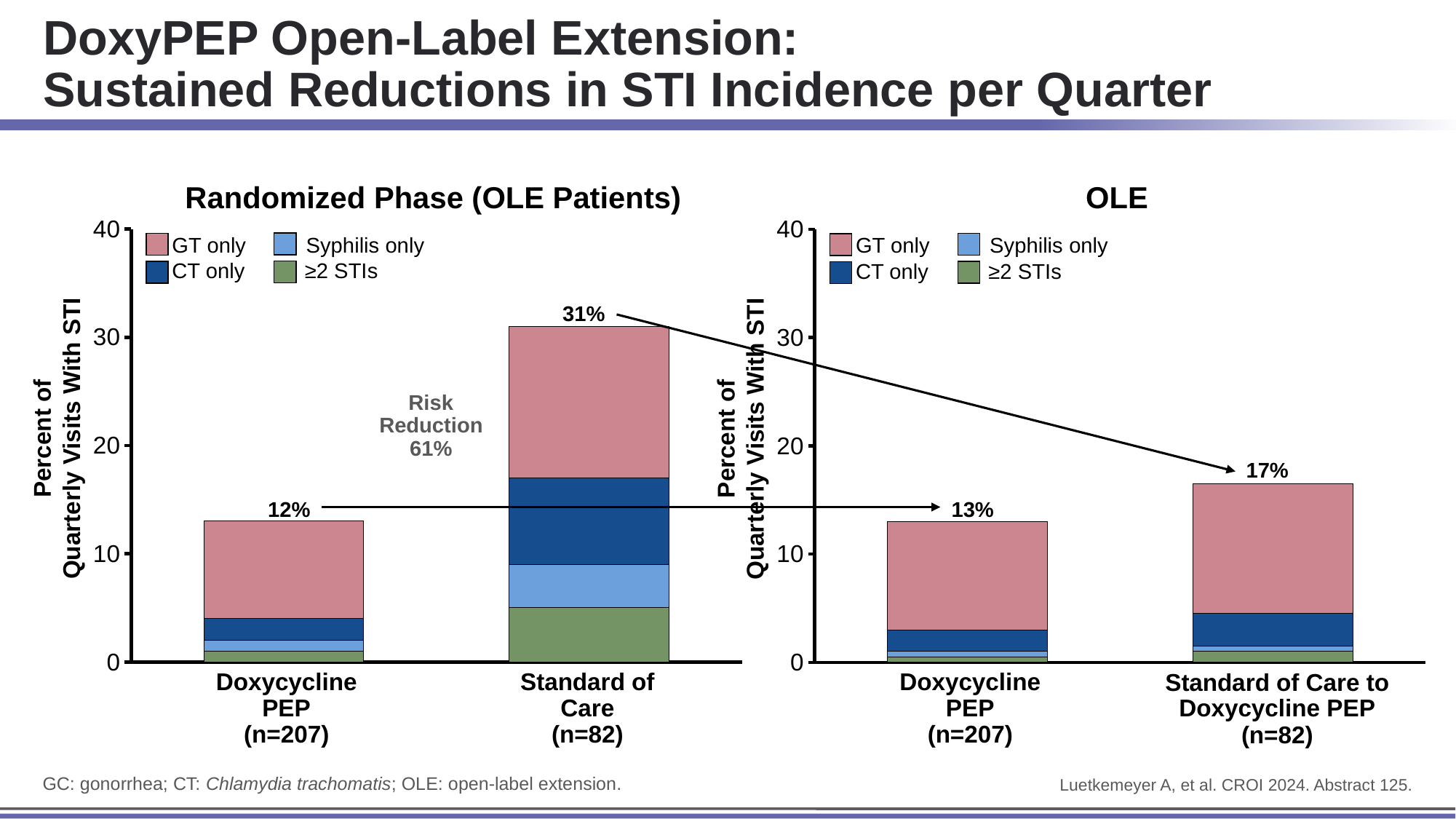
In the Randomized Phase (OLE Patients) chart, is the Standard of Care total greater or less than 30? greater In the Randomized Phase (OLE Patients) chart, what is the difference between the Standard of Care total and the Doxycycline PEP total? 19% In the OLE chart, what is the difference between the Standard of Care to Doxycycline PEP total and the Doxycycline PEP total? 4% In the Randomized Phase (OLE Patients) chart, what is the total percent of quarterly visits with STI for Doxycycline PEP (n=207)? 12% In the Randomized Phase (OLE Patients) chart, what is the total percent of quarterly visits with STI for Standard of Care (n=82)? 31% In the OLE chart, which group has the higher total percent of quarterly visits with STI? Standard of Care to Doxycycline PEP (n=82) In the Randomized Phase (OLE Patients) chart, which group has the lower total percent of quarterly visits with STI? Doxycycline PEP (n=207) In the OLE chart, what is the total percent of quarterly visits with STI for Doxycycline PEP (n=207)? 13% How many series does the legend of the OLE chart list? 4 What kind of chart is the Randomized Phase (OLE Patients) chart? Stacked bar chart In the Randomized Phase (OLE Patients) chart, what risk reduction is annotated between the two bars? 61% In the OLE chart, what is the total percent of quarterly visits with STI for Standard of Care to Doxycycline PEP (n=82)? 17%